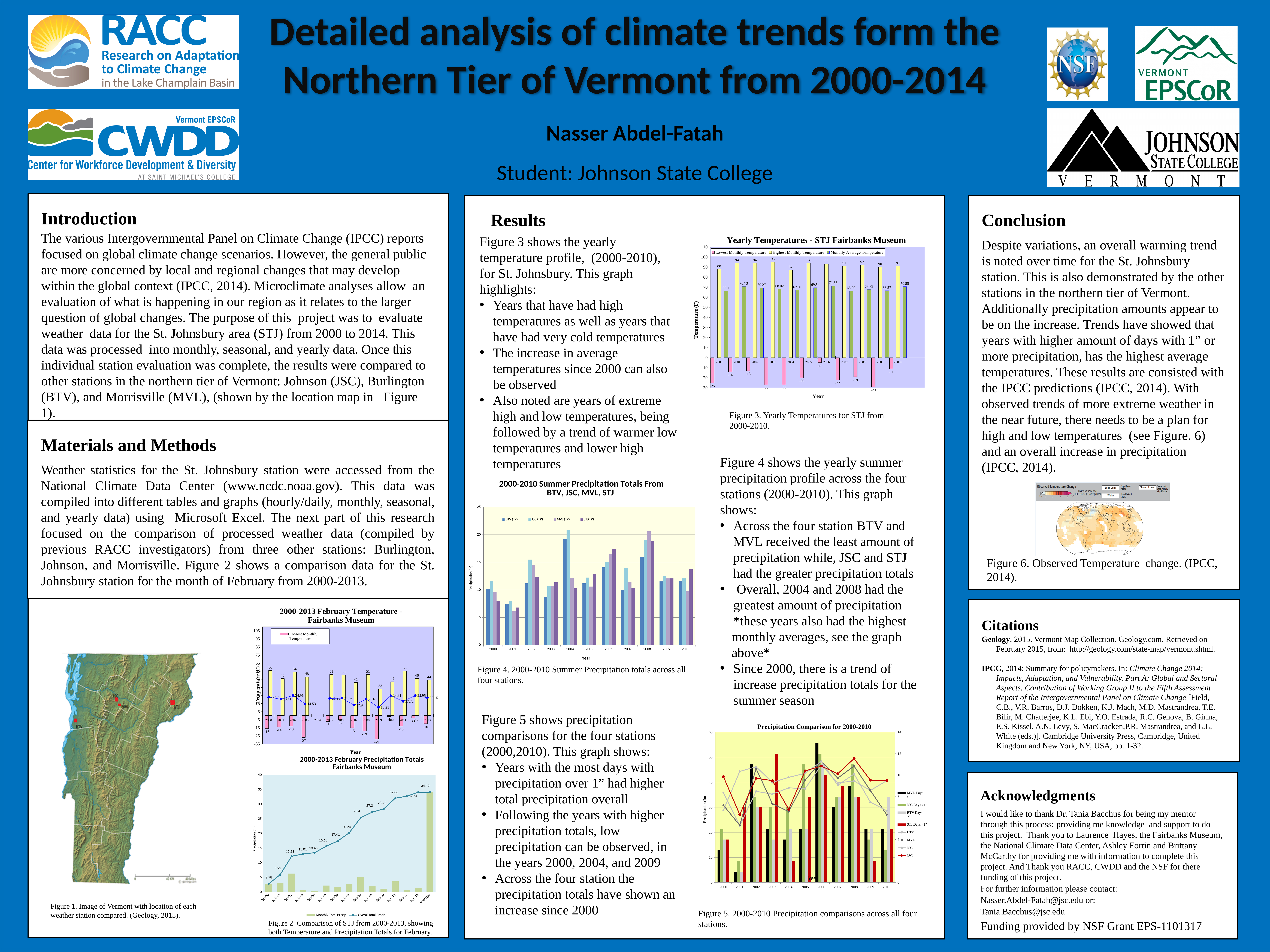
What kind of chart is the 'Yearly Temperatures - STJ Fairbanks Museum' chart? bar chart In the 'Yearly Temperatures - STJ Fairbanks Museum' chart, which year has the highest Monthly Average Temperature? 2006 How many years are plotted on the x axis of the 'Yearly Temperatures - STJ Fairbanks Museum' chart? 11 In the 'Yearly Temperatures - STJ Fairbanks Museum' chart, is the Monthly Average Temperature higher in 2006 or in 2000? 2006 In the 'Yearly Temperatures - STJ Fairbanks Museum' chart, what is the Highest Monthly Temperature for 2000? 88 In the 'Yearly Temperatures - STJ Fairbanks Museum' chart, what is the Lowest Monthly Temperature for 2009? -29 How many series does the legend of the '2000-2010 Summer Precipitation Totals From BTV, JSC, MVL, STJ' chart list? 4 What kind of chart is the '2000-2010 Summer Precipitation Totals From BTV, JSC, MVL, STJ' chart? bar chart In the 'Yearly Temperatures - STJ Fairbanks Museum' chart, what is the difference between the Highest Monthly Temperature in 2001 and in 2000? 6 In the 'Yearly Temperatures - STJ Fairbanks Museum' chart, what is the Monthly Average Temperature for 2006? 71.38 How many series does the legend of the 'Yearly Temperatures - STJ Fairbanks Museum' chart list? 3 In the 'Yearly Temperatures - STJ Fairbanks Museum' chart, which year has the lowest Lowest Monthly Temperature? 2009